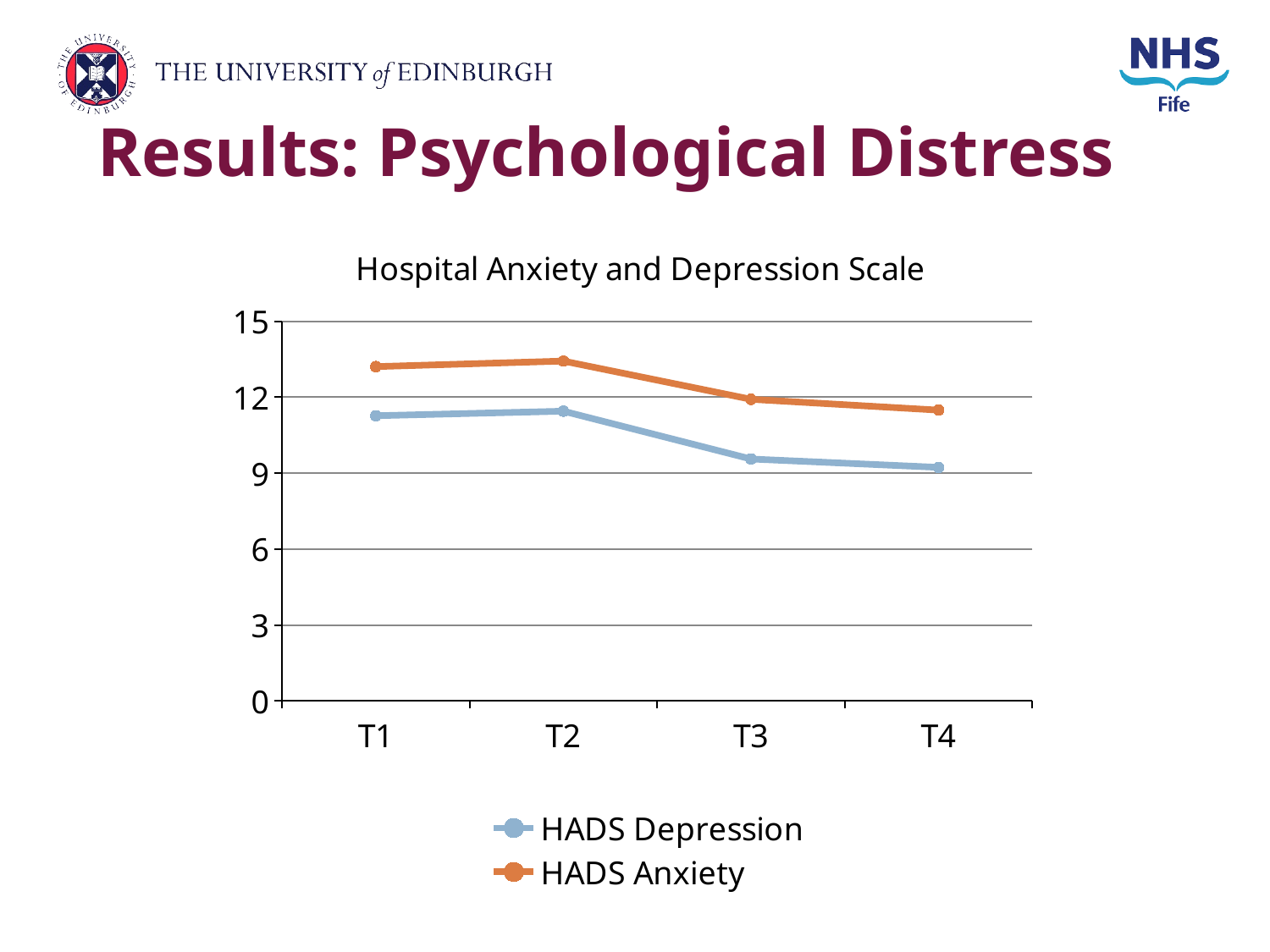
How many time points are shown on the x axis? 4 How many series does the legend list? 2 Is the HADS Anxiety value at T1 greater or less than 12? greater Is the HADS Anxiety value at T4 greater or less than 12? less Is the HADS Depression value at T1 greater or less than 12? less What is the title of the chart? Hospital Anxiety and Depression Scale For HADS Depression, which is larger, the value at T2 or the value at T4? T2 At T1, which series has the higher value, HADS Anxiety or HADS Depression? HADS Anxiety What kind of chart is shown on the slide? line chart Do the HADS Depression values rise or fall overall from T1 to T4? fall Which series is drawn in orange? HADS Anxiety